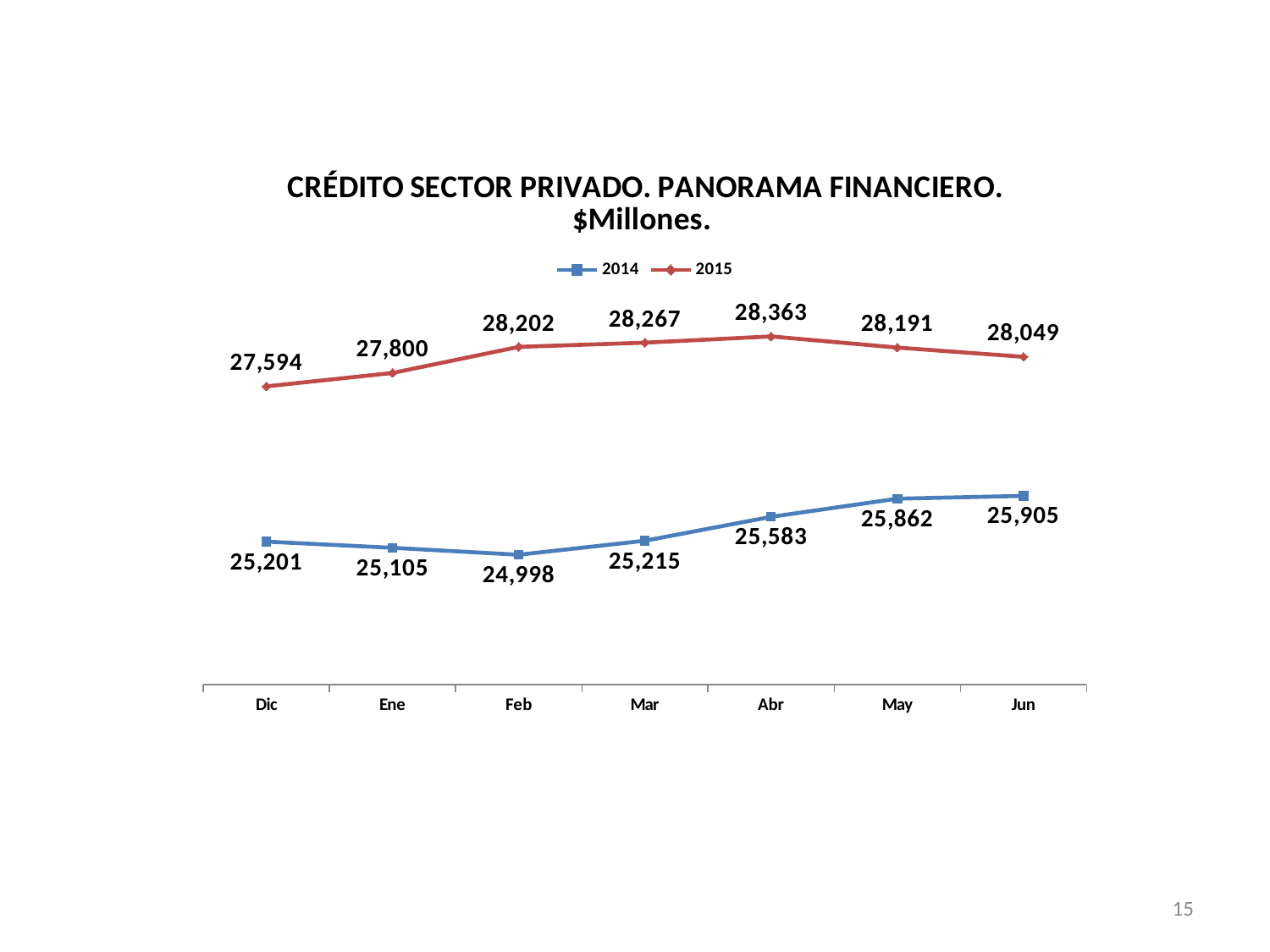
In which month does the 2015 series reach its highest value? Abr What is the value for 2015 in Abr? 28,363 In which month does the 2014 series have its lowest value? Feb How much higher is the 2015 value in Jun than in Dic? 455 What is the value for 2014 in Feb? 24,998 Which is larger, the 2014 value in Mar or the 2014 value in Dic? Mar In which month does the 2014 series reach its highest value? Jun What type of chart is shown on the slide? Line chart What is the difference between the 2015 and 2014 values in Abr? 2,780 How many months are shown on the x axis? 7 What is the value for 2015 in Dic? 27,594 How many series does the legend list? 2